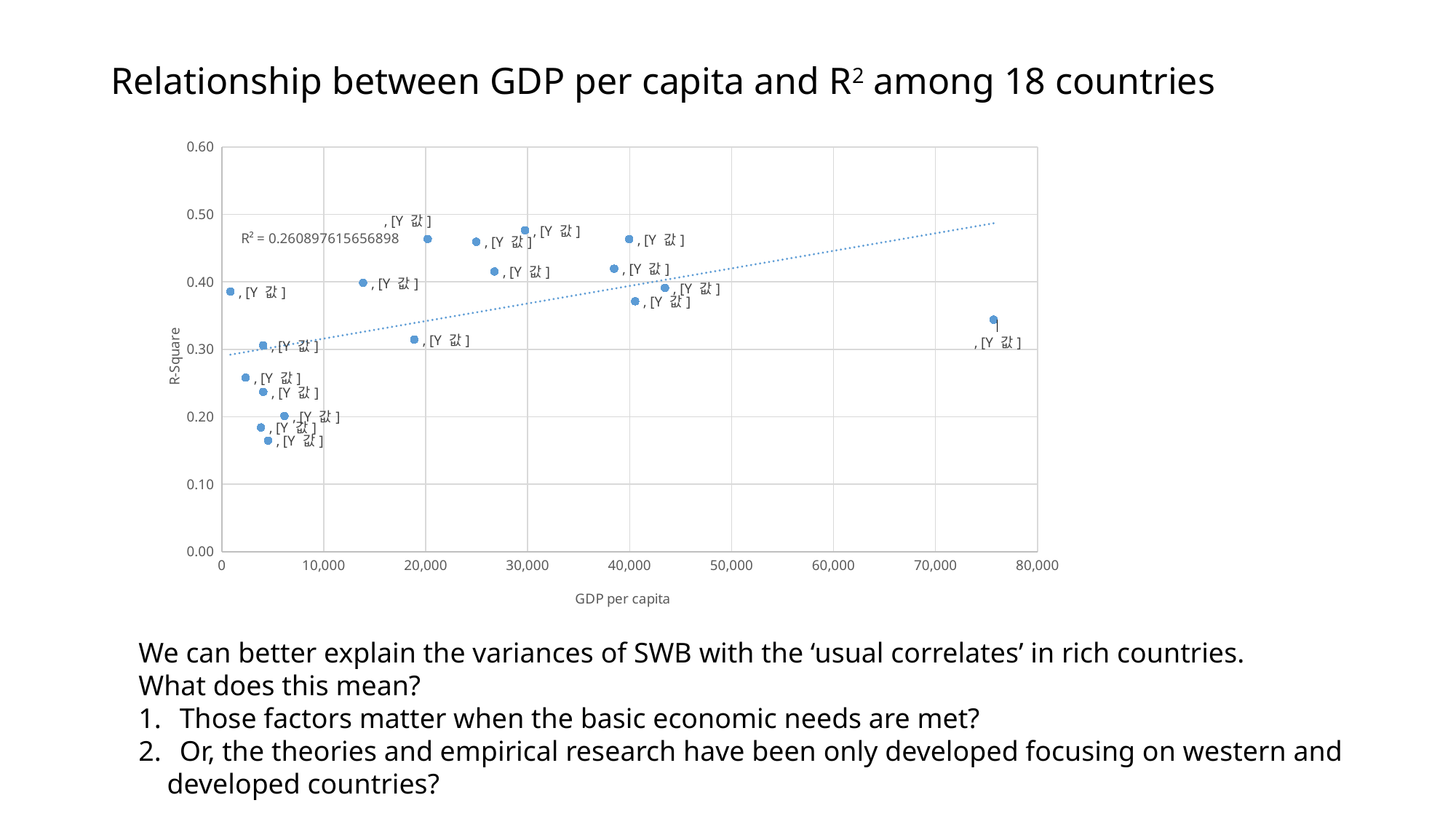
Is the R-Square value for the point at roughly 14,000 GDP per capita greater or less than 0.30? greater What is the label of the vertical axis? R-Square What is the maximum value shown on the vertical axis? 0.60 Is the R-Square value for the point at roughly 30,000 GDP per capita greater or less than 0.40? greater How many data points are plotted in the scatter chart? 18 What R² value is printed on the chart for the trendline? R² = 0.260897615656898 Is the R-Square value for the point with the highest GDP per capita (around 75,000) greater or less than 0.40? less What kind of chart is shown on the slide? scatter chart What is the title of the chart? Relationship between GDP per capita and R² among 18 countries Does the dotted trendline rise or fall as GDP per capita increases? rise